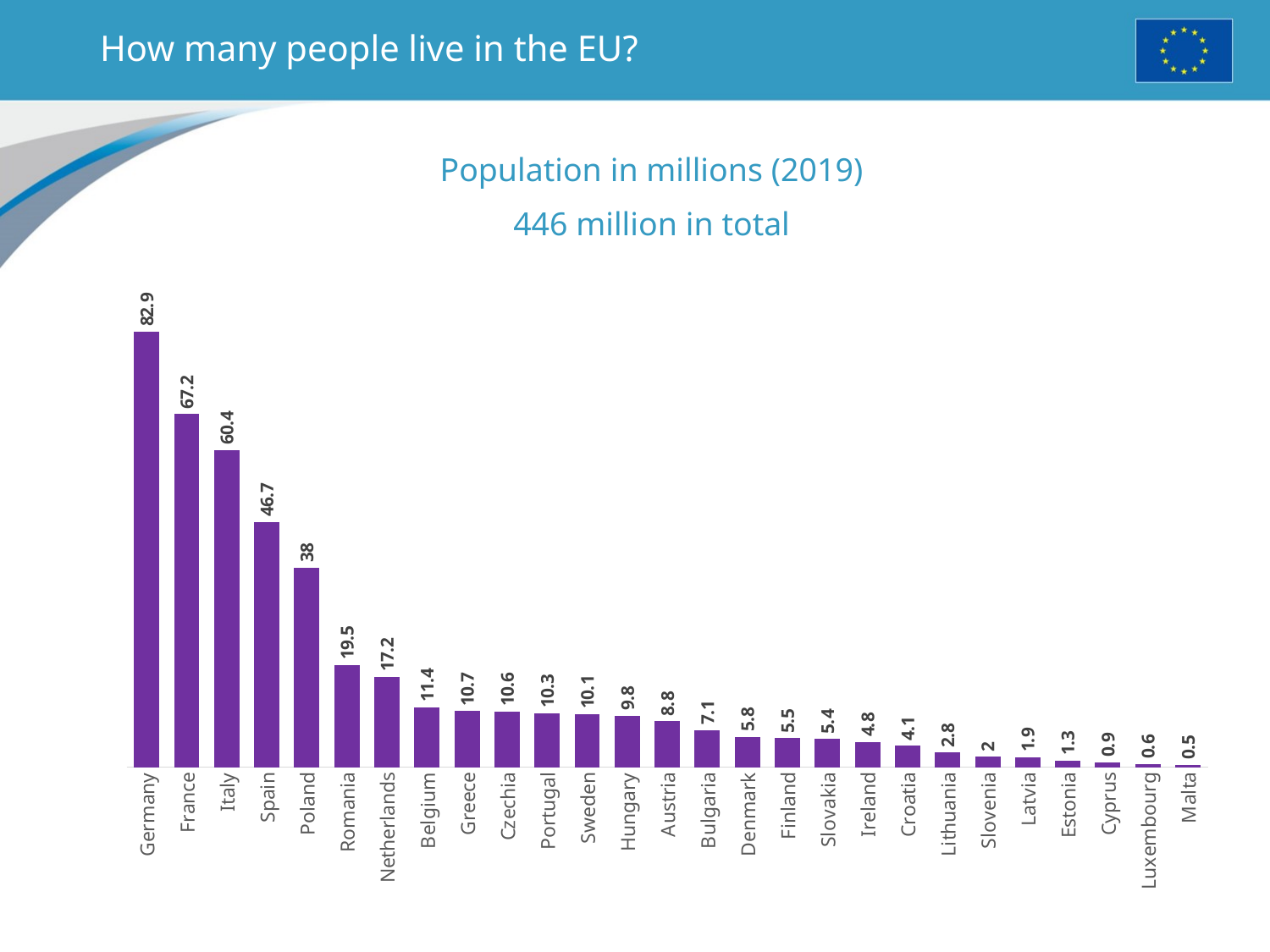
What is the difference in population (millions) between Spain and Poland? 8.7 How many countries are shown in the chart? 27 Which country has the lowest population in the chart? Malta What is the population in millions shown for Slovakia? 5.4 Which country has the highest population in the chart? Germany What is the population in millions shown for Germany? 82.9 Which has a larger population, Hungary or Bulgaria? Hungary What type of chart is shown on the slide? Bar chart What is the population in millions shown for Netherlands? 17.2 Do the values rise or fall from left to right along the x axis? Fall What is the difference in population (millions) between France and Italy? 6.8 Which has a larger population, Romania or Belgium? Romania